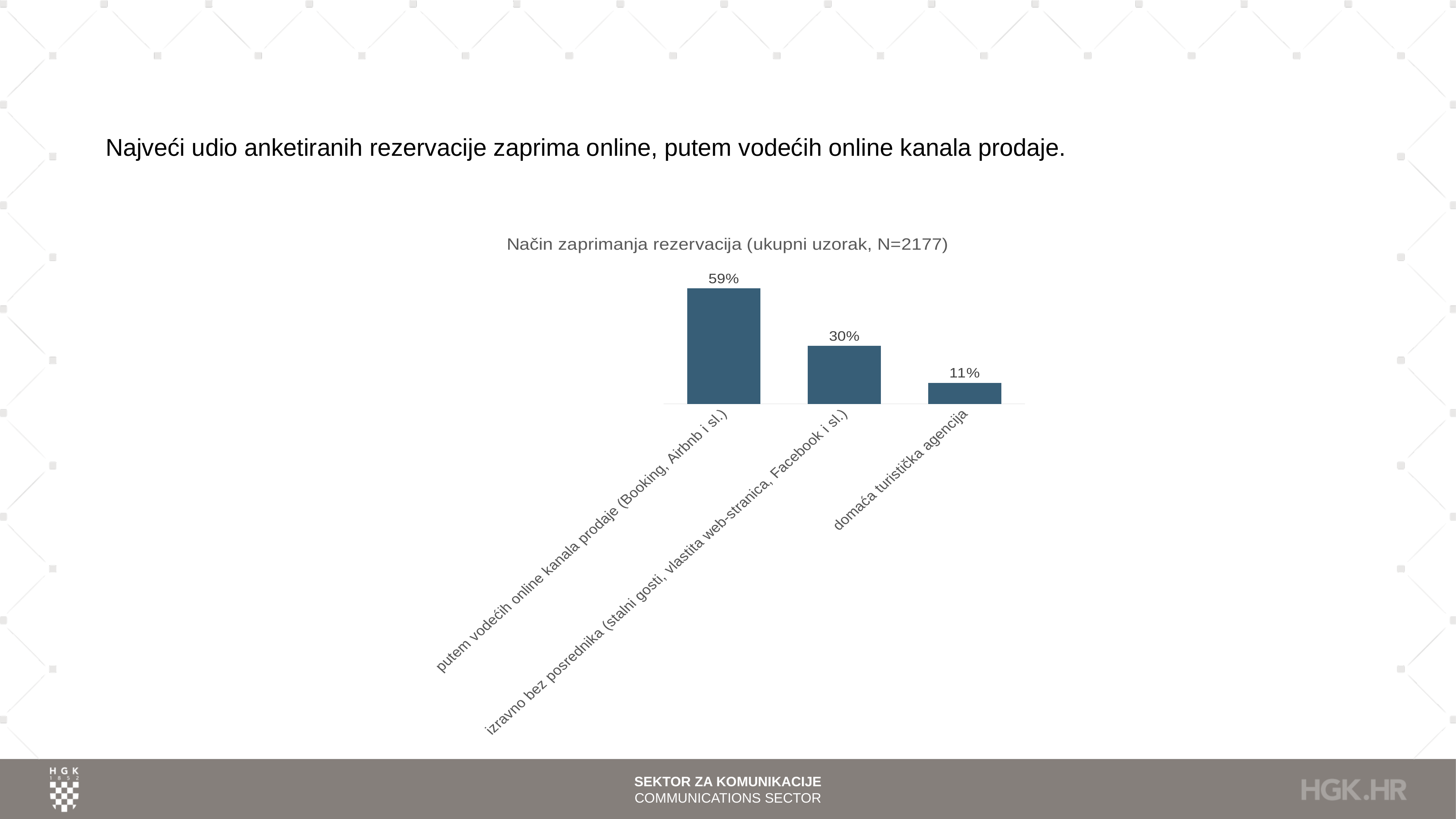
Do the values rise or fall from left to right across the categories? fall Which category has the highest value? putem vodećih online kanala prodaje (Booking, Airbnb i sl.) What kind of chart is shown on the slide? bar chart What is the difference between the values for 'putem vodećih online kanala prodaje' and 'izravno bez posrednika'? 29% Which category has the lowest value? domaća turistička agencija What is the value for 'putem vodećih online kanala prodaje (Booking, Airbnb i sl.)'? 59% What is the difference between the values for 'izravno bez posrednika' and 'domaća turistička agencija'? 19% What is the title of the chart? Način zaprimanja rezervacija (ukupni uzorak, N=2177) Which is larger: the value for 'izravno bez posrednika' or for 'domaća turistička agencija'? izravno bez posrednika How many categories are shown in the chart? 3 What is the value for 'izravno bez posrednika (stalni gosti, vlastita web-stranica, Facebook i sl.)'? 30% What is the value for 'domaća turistička agencija'? 11%